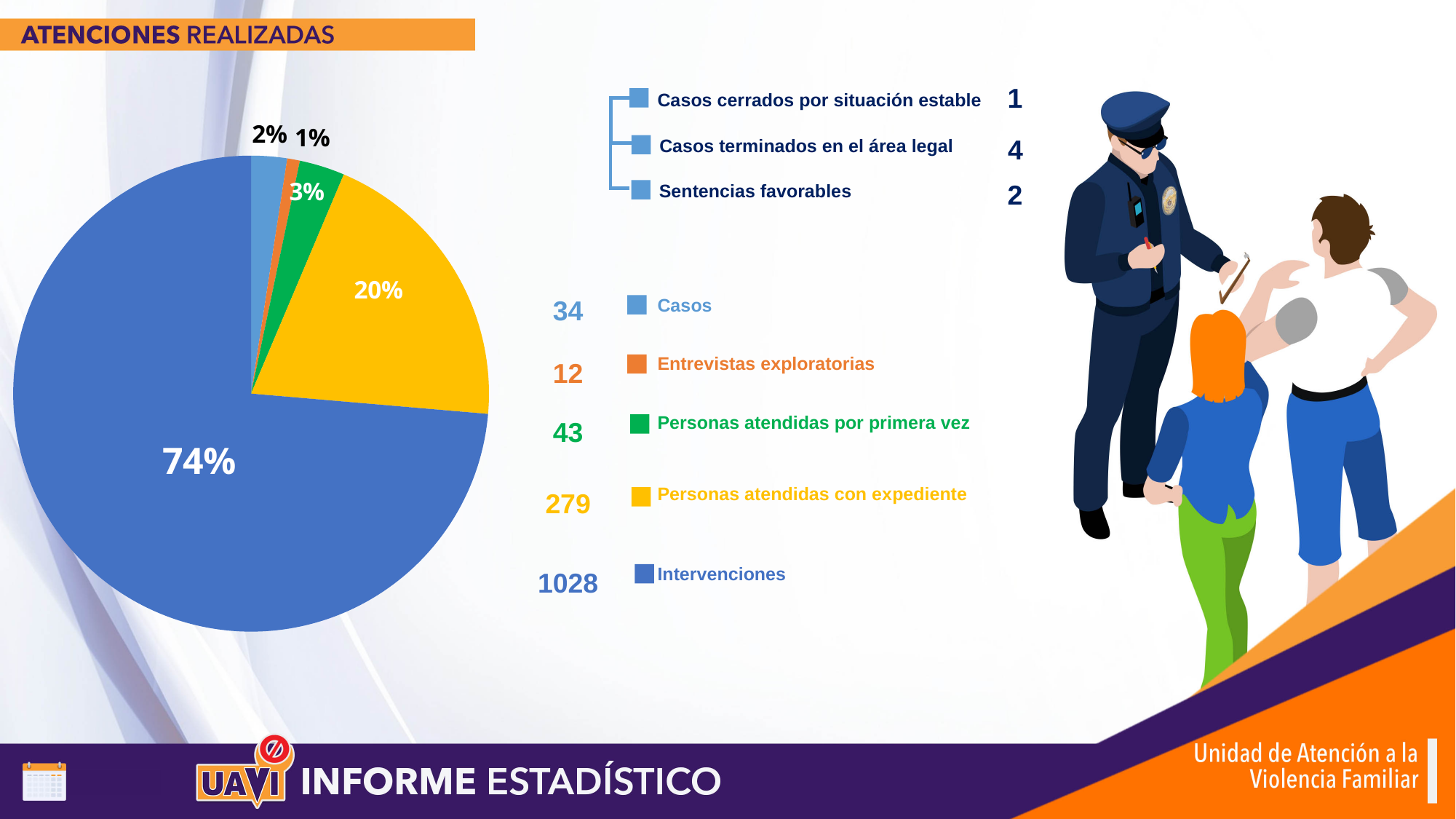
What kind of chart is shown on the slide? pie chart What is the value shown for Entrevistas exploratorias in the legend? 12 Which category has the largest slice of the pie chart? Intervenciones Which is larger, the value for Personas atendidas por primera vez or the value for Casos? Personas atendidas por primera vez What percentage of the pie chart does Personas atendidas con expediente represent? 20% What is the difference between the values for Intervenciones and Personas atendidas con expediente? 749 What percentage of the pie chart does Personas atendidas por primera vez represent? 3% How many categories does the pie chart have? 5 What percentage of the pie chart does Intervenciones represent? 74% What is the value shown for Intervenciones in the legend? 1028 What is the value shown for Casos in the legend? 34 Which category has the smallest slice of the pie chart? Entrevistas exploratorias